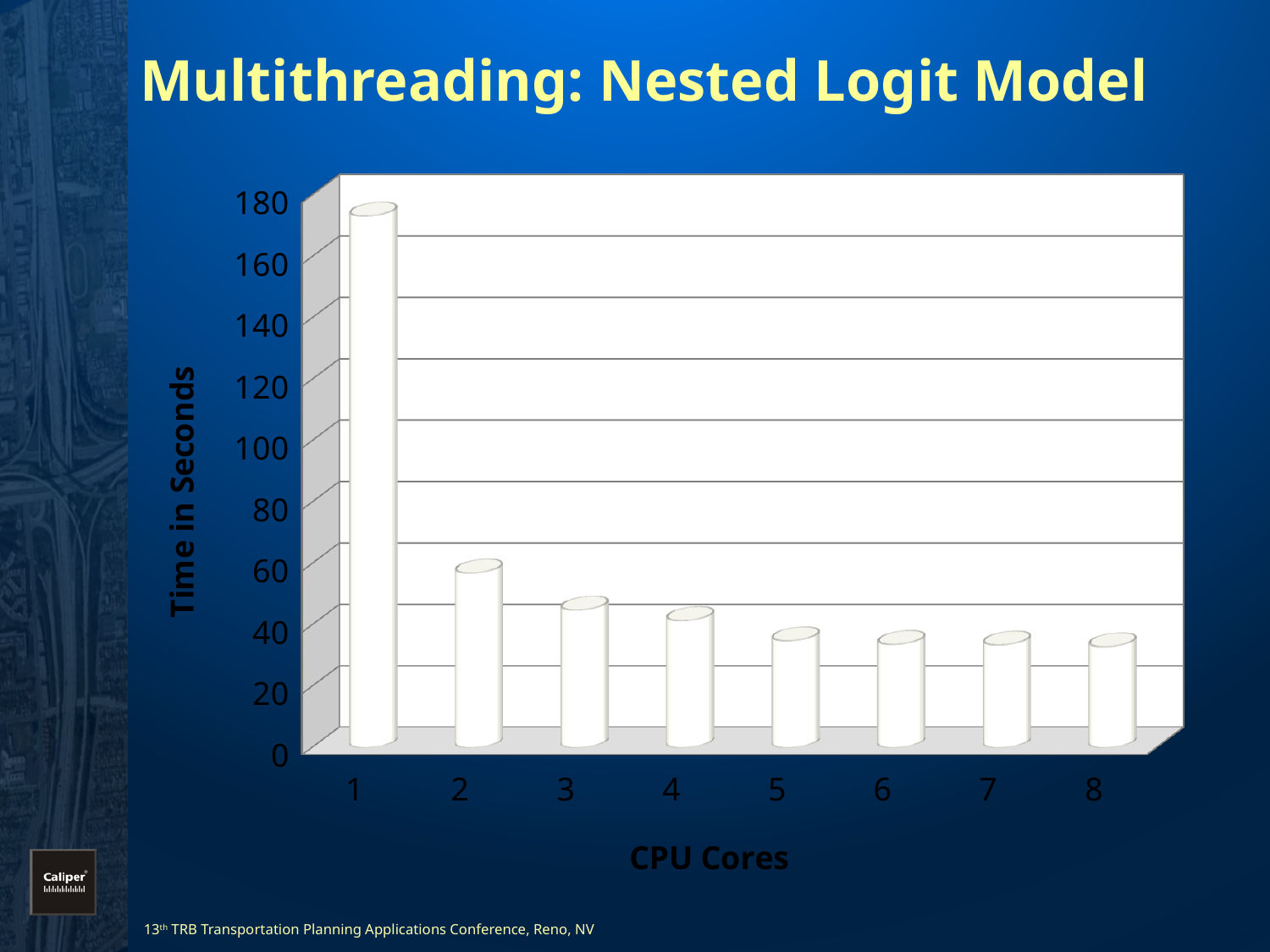
Is the time for 3 CPU cores greater or less than 60 seconds? less Do the times rise or fall as the number of CPU cores increases along the x axis? fall Is the time for 2 CPU cores greater or less than 80 seconds? less Which number of CPU cores has the highest time in seconds? 1 What is the label of the vertical axis? Time in Seconds What kind of chart is shown on the slide? bar chart Is the time for 2 CPU cores greater or less than 40 seconds? greater Which has the larger time, 2 CPU cores or 5 CPU cores? 2 How many CPU core categories are plotted on the x axis? 8 Which has the larger time, 1 CPU core or 2 CPU cores? 1